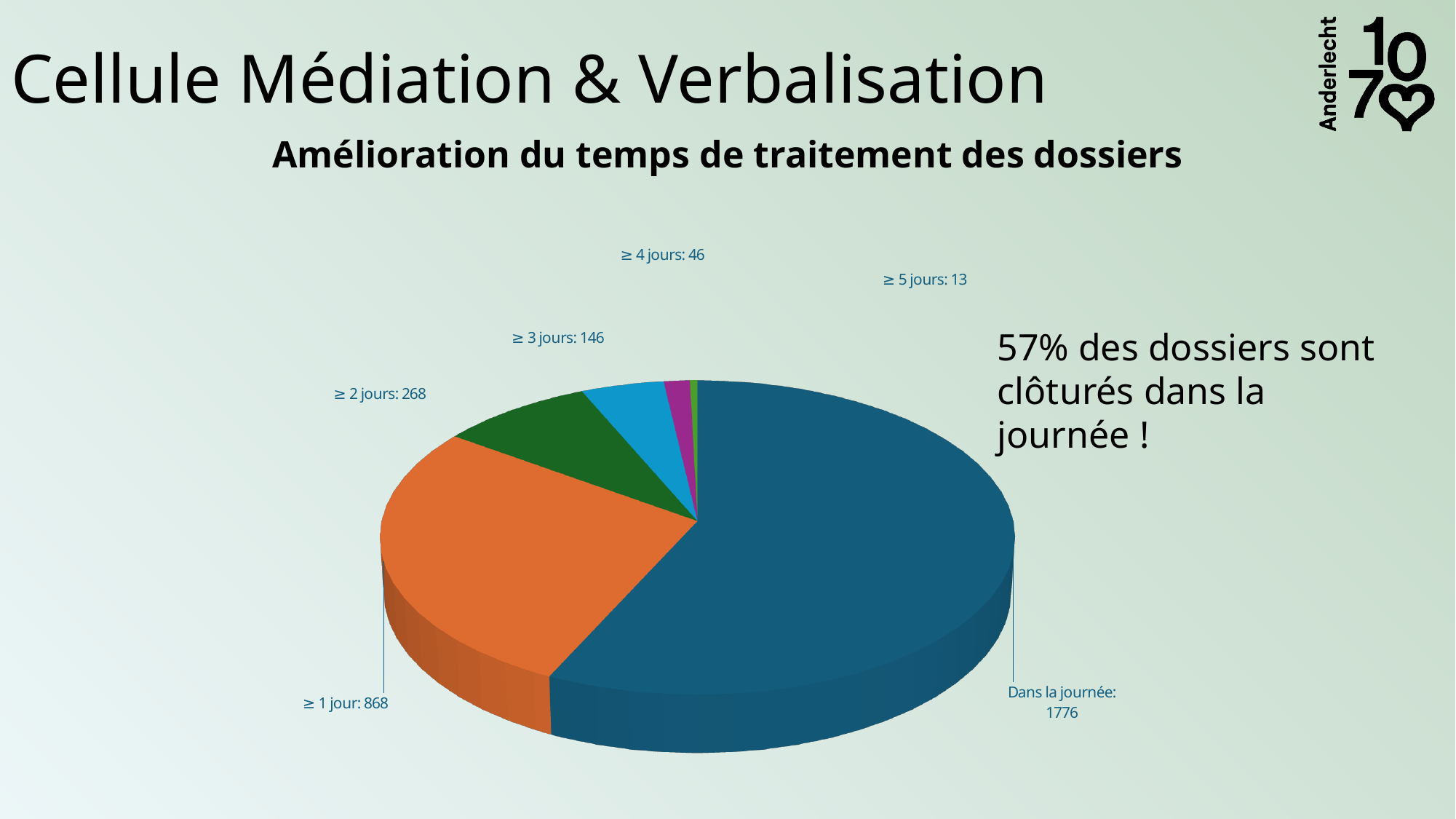
What is the value for "≥ 3 jours"? 146 What is the value for "≥ 2 jours"? 268 What is the value for "≥ 5 jours"? 13 What is the difference between the values for "Dans la journée" and "≥ 1 jour"? 908 Which is larger, the value for "≥ 2 jours" or the value for "≥ 3 jours"? ≥ 2 jours What share of the dossiers are closed within the day ("Dans la journée"), according to the slide? 57% Which category has the smallest slice? ≥ 5 jours Which category has the largest slice? Dans la journée What is the value for "≥ 1 jour"? 868 What kind of chart is shown on the slide? pie chart How many slices does the pie chart have? 6 What is the value for "Dans la journée"? 1776